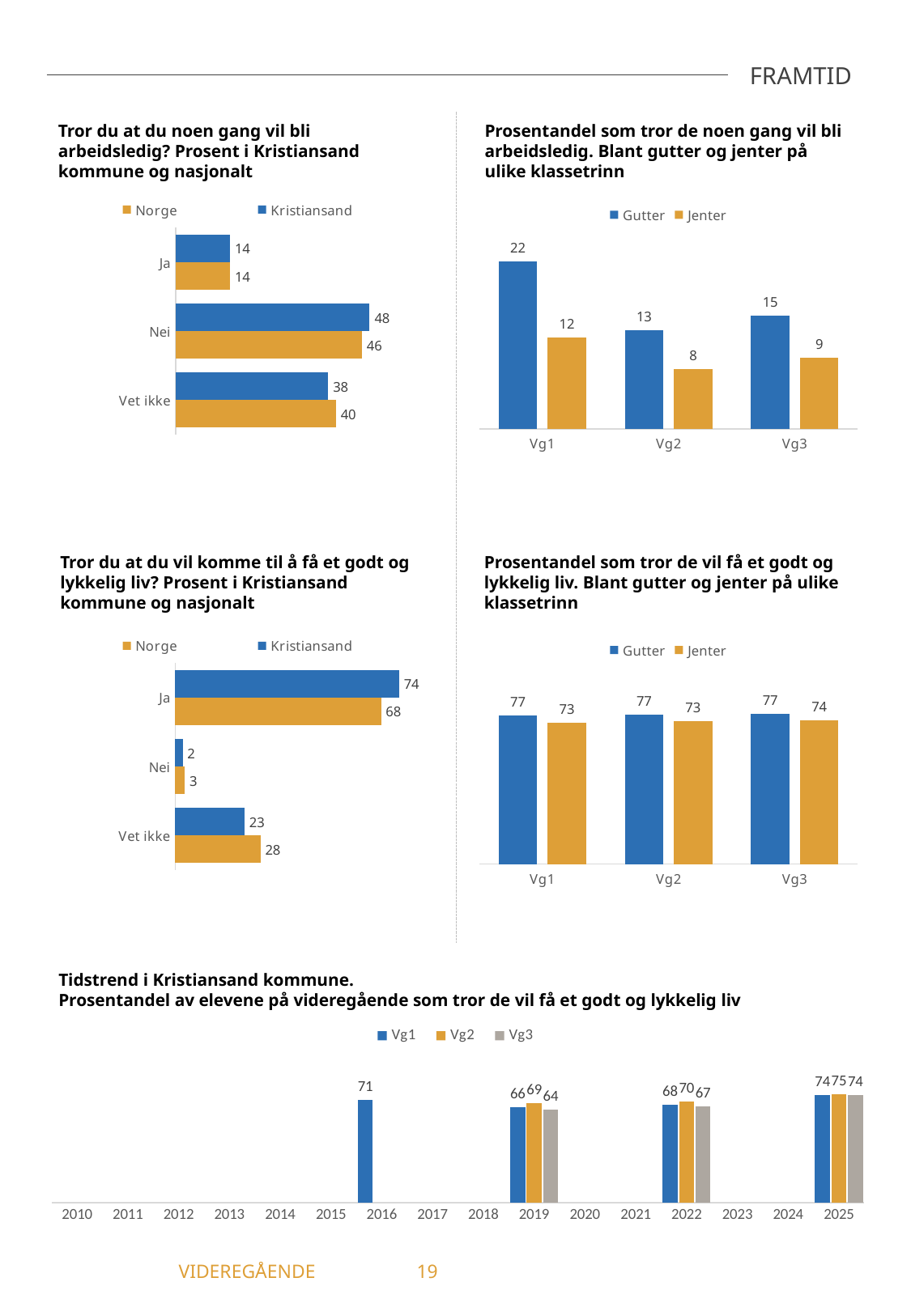
In the middle-right chart 'Prosentandel som tror de vil få et godt og lykkelig liv', what is the Jenter value for Vg3? 74 In the middle-left chart 'Tror du at du vil komme til å få et godt og lykkelig liv?', which is larger for 'Vet ikke': Norge or Kristiansand? Norge In the bottom chart 'Tidstrend i Kristiansand kommune', how many series does the legend list? 3 In the top-left chart 'Tror du at du noen gang vil bli arbeidsledig?', what is the difference between the Norge and Kristiansand values for 'Vet ikke'? 2 In the top-right chart 'Prosentandel som tror de noen gang vil bli arbeidsledig', how many series does the legend list? 2 In the bottom chart 'Tidstrend i Kristiansand kommune', what is the Vg2 value for 2022? 70 In the middle-right chart 'Prosentandel som tror de vil få et godt og lykkelig liv', what is the difference between Gutter and Jenter for Vg1? 4 In the top-left chart 'Tror du at du noen gang vil bli arbeidsledig?', what is the Kristiansand value for 'Nei'? 48 In the top-right chart 'Prosentandel som tror de noen gang vil bli arbeidsledig', which class level has the highest value for Gutter? Vg1 In the middle-left chart 'Tror du at du vil komme til å få et godt og lykkelig liv?', what is the Norge value for 'Ja'? 68 In the top-right chart 'Prosentandel som tror de noen gang vil bli arbeidsledig', what is the Jenter value for Vg2? 8 What kind of chart is the bottom chart 'Tidstrend i Kristiansand kommune'? Bar chart